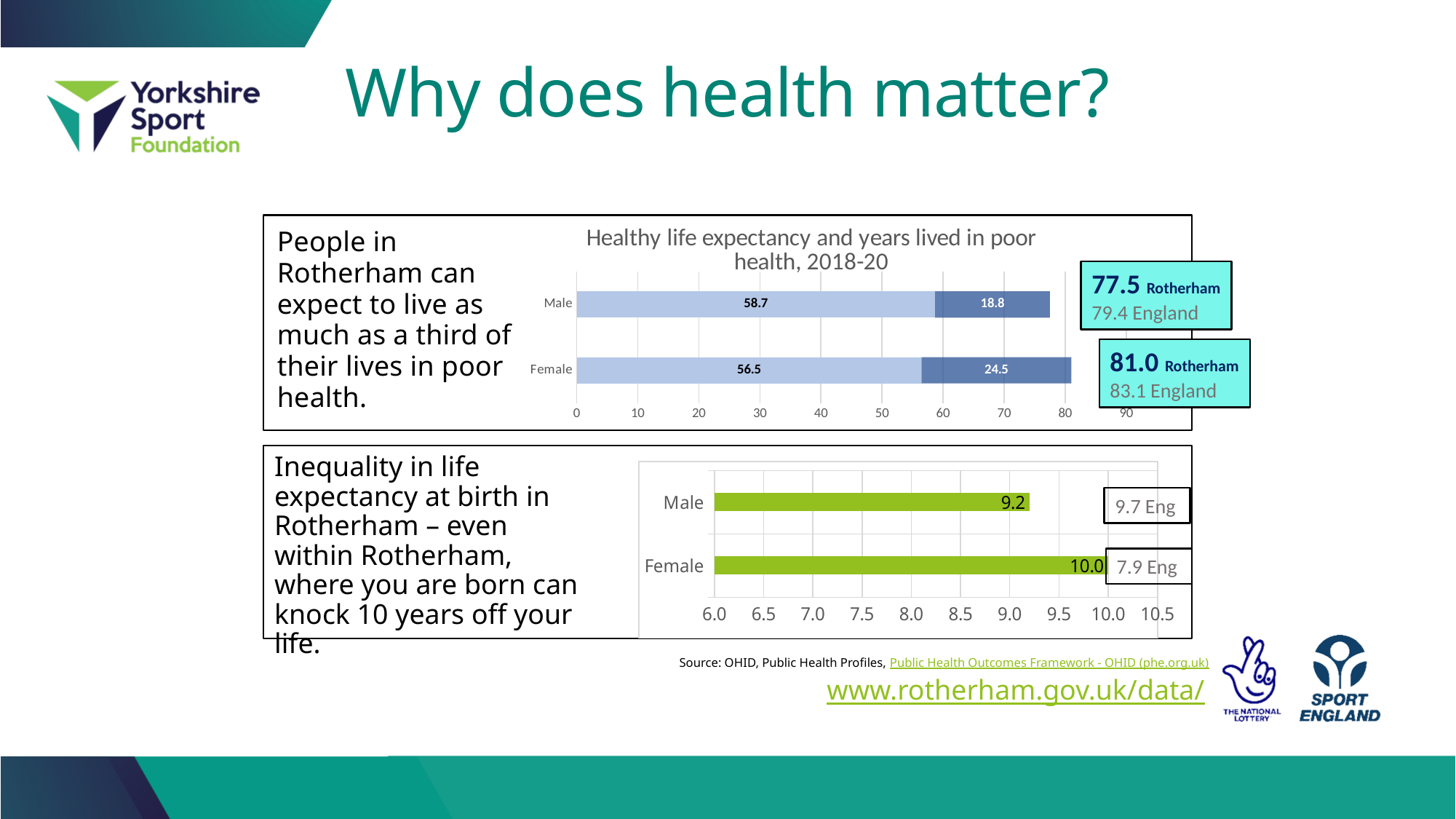
In the bottom chart on the slide, what is the value shown for Female? 10.0 In the top chart, 'Healthy life expectancy and years lived in poor health, 2018-20', what is the healthy life expectancy value shown for Male? 58.7 In the bottom chart on the slide, what is the difference between the Female and Male values? 0.8 What type of chart is the top chart, 'Healthy life expectancy and years lived in poor health, 2018-20'? Stacked bar chart In the top chart, 'Healthy life expectancy and years lived in poor health, 2018-20', what is the total length of the Female stacked bar? 81.0 In the top chart, 'Healthy life expectancy and years lived in poor health, 2018-20', what is the total length of the Male stacked bar? 77.5 In the top chart, 'Healthy life expectancy and years lived in poor health, 2018-20', what is the difference between the years lived in poor health for Female and for Male? 5.7 In the top chart, 'Healthy life expectancy and years lived in poor health, 2018-20', which has the larger healthy life expectancy segment, Male or Female? Male In the top chart, 'Healthy life expectancy and years lived in poor health, 2018-20', how many years lived in poor health are shown for Female? 24.5 In the bottom chart on the slide, what is the value shown for Male? 9.2 In the bottom chart on the slide, which category has the higher value, Male or Female? Female In the top chart, 'Healthy life expectancy and years lived in poor health, 2018-20', how many categories are plotted on the vertical axis? 2